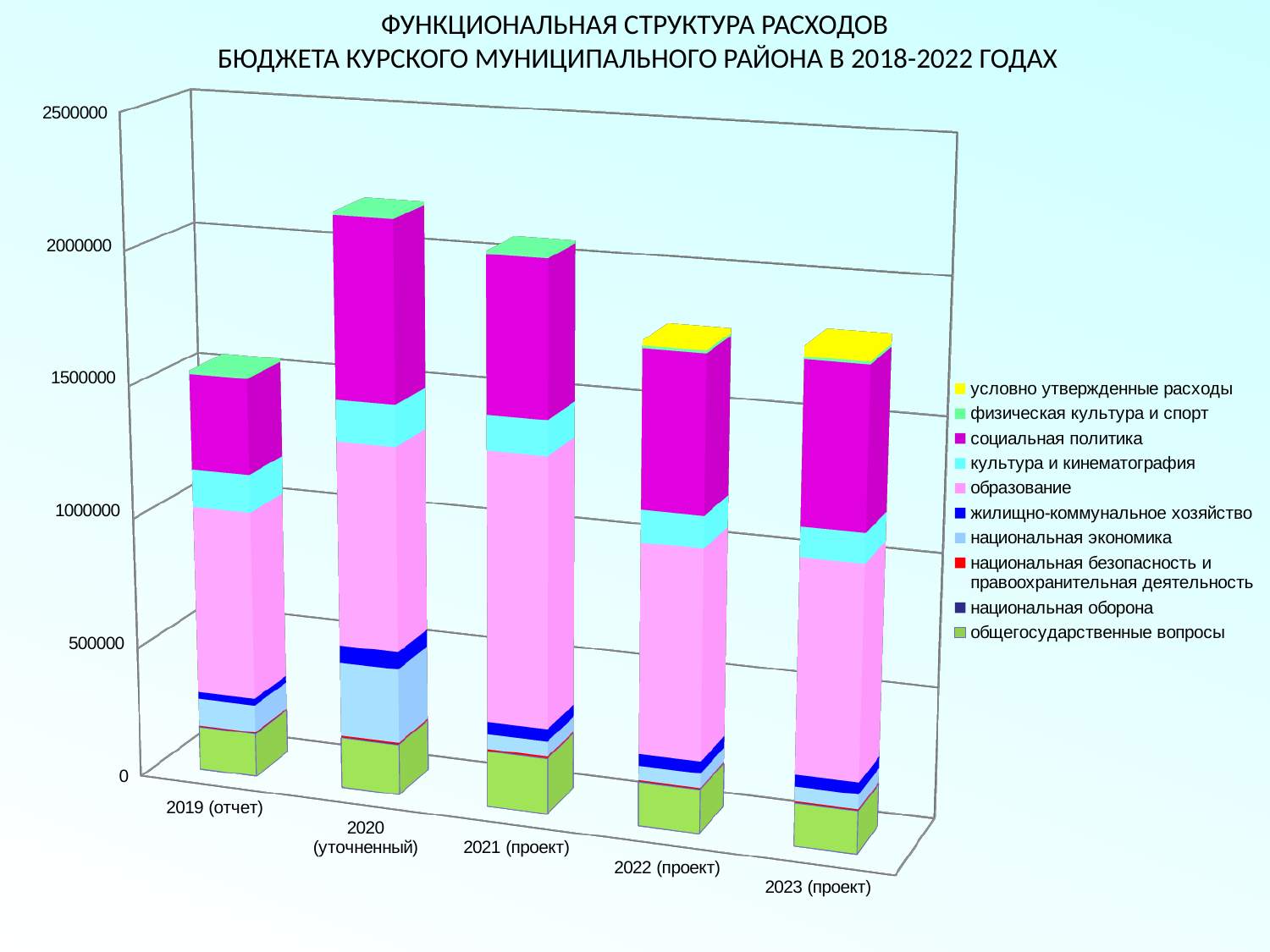
Is the total bar for 2020 (уточненный) greater or less than 2000000? greater Which series is shown in yellow in the legend? условно утвержденные расходы Which total bar is larger, 2019 (отчет) or 2020 (уточненный)? 2020 (уточненный) How many year categories are shown along the x axis? 5 Is the total bar for 2019 (отчет) greater or less than 2000000? less How many series does the legend list? 10 Which year has the highest total expenditure bar? 2020 (уточненный) Which total bar is larger, 2020 (уточненный) or 2021 (проект)? 2020 (уточненный) Which year has the lowest total expenditure bar? 2019 (отчет) What is the title of the chart? ФУНКЦИОНАЛЬНАЯ СТРУКТУРА РАСХОДОВ БЮДЖЕТА КУРСКОГО МУНИЦИПАЛЬНОГО РАЙОНА В 2018-2022 ГОДАХ What kind of chart is shown on the slide? Stacked bar chart Is the total bar for 2022 (проект) greater or less than 1500000? greater